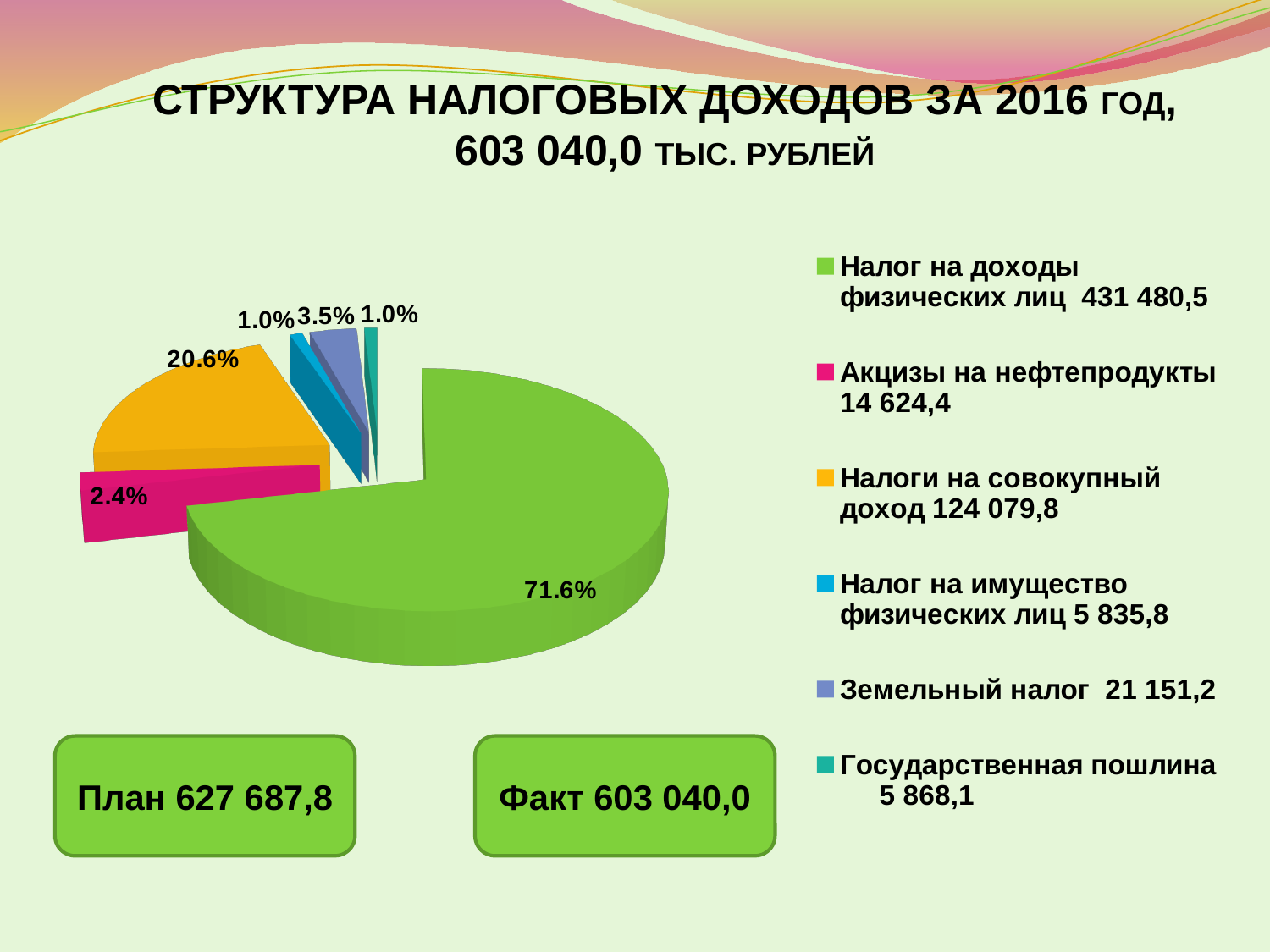
How many slices does the pie chart have? 6 What share of the pie does Налоги на совокупный доход take? 20.6% What is the difference in percentage points between the share for Налог на доходы физических лиц and the share for Налоги на совокупный доход? 51.0% What value does the legend give for Налог на имущество физических лиц? 5 835,8 Which is larger: the share for Налоги на совокупный доход or the share for Земельный налог? Налоги на совокупный доход What share of the pie does Земельный налог take? 3.5% What share of the pie does Акцизы на нефтепродукты take? 2.4% What value does the legend give for Государственная пошлина? 5 868,1 How many entries does the legend list? 6 Which category has the largest share of the pie? Налог на доходы физических лиц What kind of chart is shown on the slide? pie chart